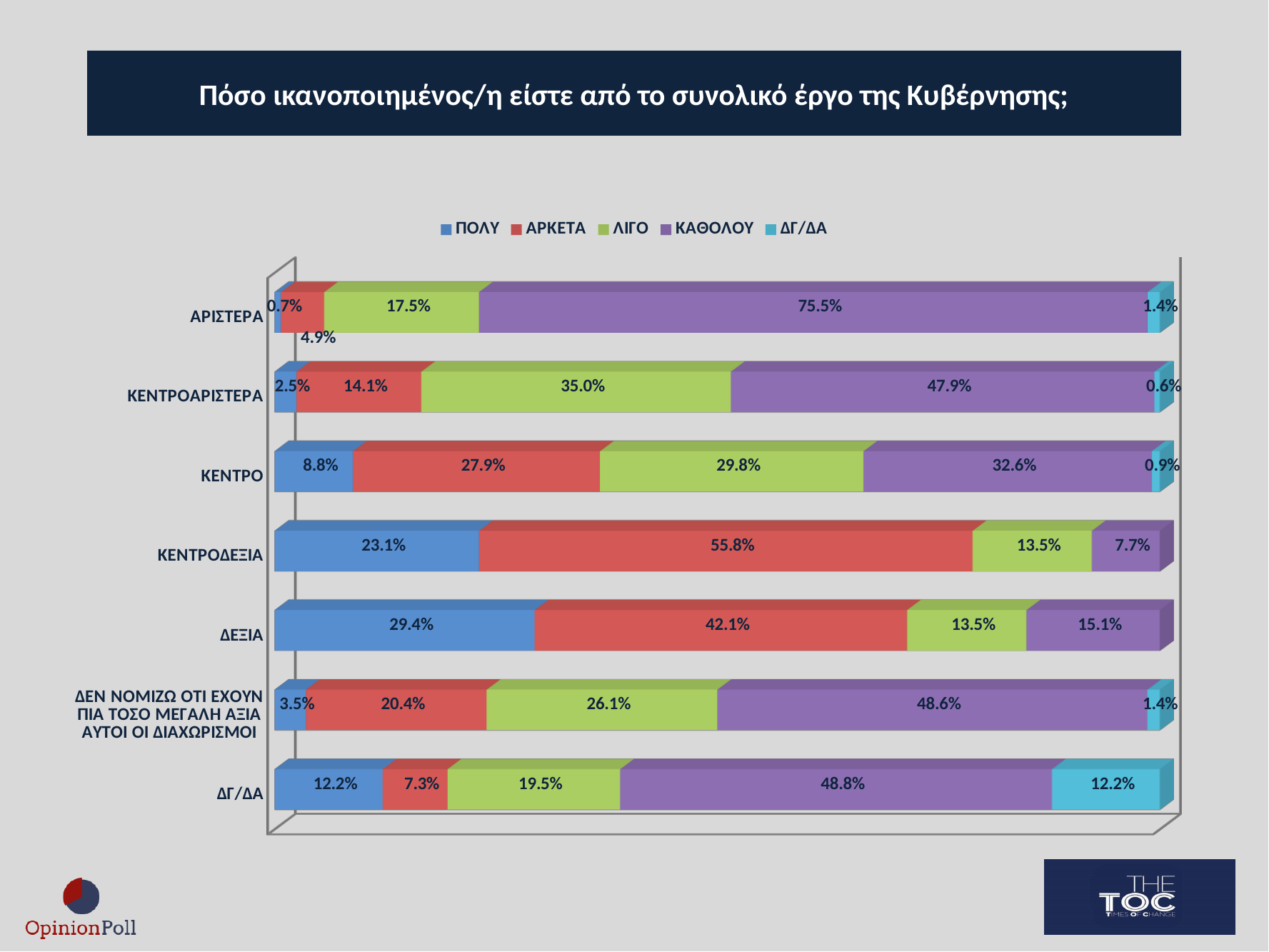
What is the ΑΡΚΕΤΑ value for ΚΕΝΤΡΟΔΕΞΙΑ? 55.8% What is the ΚΑΘΟΛΟΥ value for ΑΡΙΣΤΕΡΑ? 75.5% What is the ΛΙΓΟ value for ΚΕΝΤΡΟΑΡΙΣΤΕΡΑ? 35.0% How many categories are plotted on the chart? 7 How many series does the legend list? 5 Which is larger: the ΑΡΚΕΤΑ value for ΚΕΝΤΡΟ or the ΑΡΚΕΤΑ value for ΔΕΞΙΑ? ΔΕΞΙΑ Which category has the lowest ΠΟΛΥ value? ΑΡΙΣΤΕΡΑ Which category has the highest ΠΟΛΥ value? ΔΕΞΙΑ What type of chart is shown on the slide? Stacked bar chart What is the difference between the ΚΑΘΟΛΟΥ values for ΑΡΙΣΤΕΡΑ and ΚΕΝΤΡΟΑΡΙΣΤΕΡΑ? 27.6 percentage points What is the ΠΟΛΥ value for ΔΕΞΙΑ? 29.4% What colour represents the ΚΑΘΟΛΟΥ series in the legend? Purple